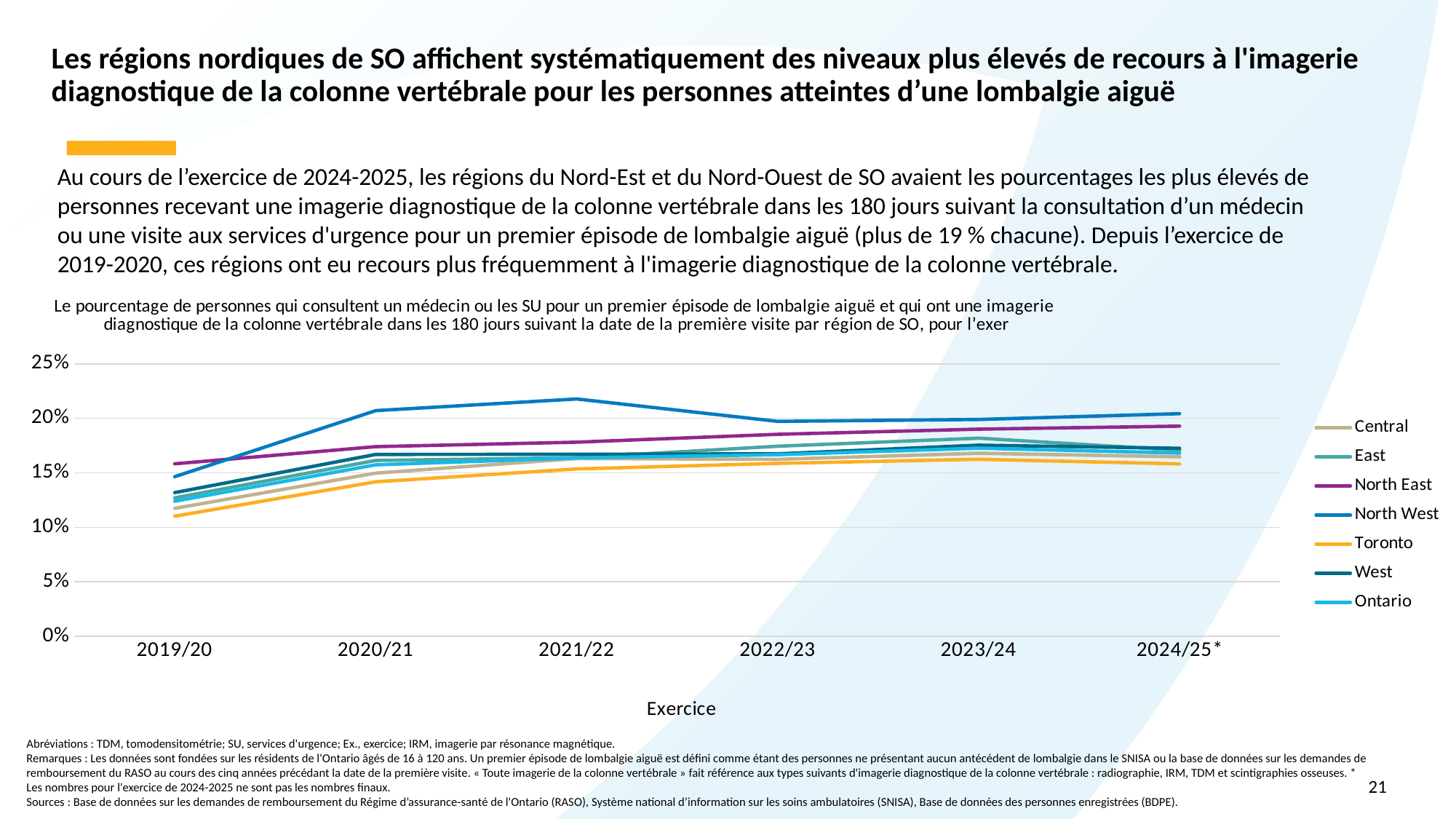
Which region has the highest value in 2019/20? North East What is the label of the x axis? Exercice Which region has the highest value in 2021/22? North West In 2019/20, which is larger: the value for North West or the value for Toronto? North West Does the value for North West rise or fall from 2019/20 to 2021/22? rise Is the value for Toronto in 2019/20 greater or less than 15%? less Is the value for North West in 2021/22 greater or less than 20%? greater Is the value for Central in 2019/20 greater or less than 15%? less How many fiscal years are plotted along the x axis? 6 What kind of chart is shown on the slide? line chart How many series does the legend list? 7 Which region has the lowest value in 2019/20? Toronto